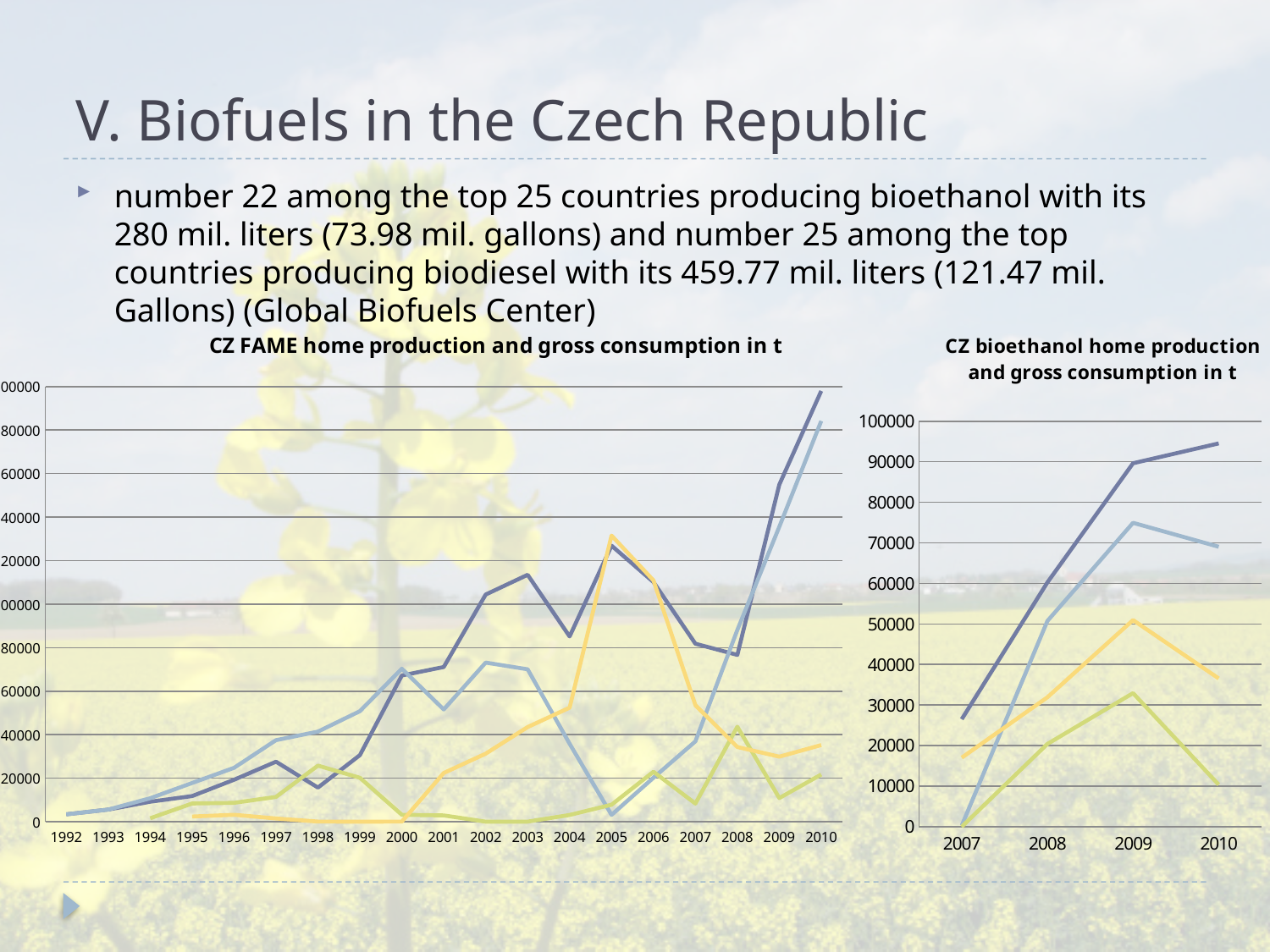
What type of chart is the left chart, 'CZ FAME home production and gross consumption in t'? line chart In the left chart, 'CZ FAME home production and gross consumption in t', does the dark blue line rise or fall from 2008 to 2010? rise In the left chart, 'CZ FAME home production and gross consumption in t', how many years are shown on the x axis? 19 In the left chart, 'CZ FAME home production and gross consumption in t', what is the first year on the x axis? 1992 In the right chart, 'CZ bioethanol home production and gross consumption in t', what is the highest value labelled on the y axis? 100000 In the right chart, 'CZ bioethanol home production and gross consumption in t', is the value of the dark blue line in 2010 greater or less than 90000? greater In the right chart, 'CZ bioethanol home production and gross consumption in t', how many years are shown on the x axis? 4 In the right chart, 'CZ bioethanol home production and gross consumption in t', is the value of the dark blue line in 2007 greater or less than 30000? less In the left chart, 'CZ FAME home production and gross consumption in t', is the value of the dark blue line in 2010 greater or less than 180000? greater What type of chart is the right chart, 'CZ bioethanol home production and gross consumption in t'? line chart In the right chart, 'CZ bioethanol home production and gross consumption in t', does the dark blue line rise or fall from 2007 to 2010? rise In the right chart, 'CZ bioethanol home production and gross consumption in t', does the green line rise or fall from 2009 to 2010? fall